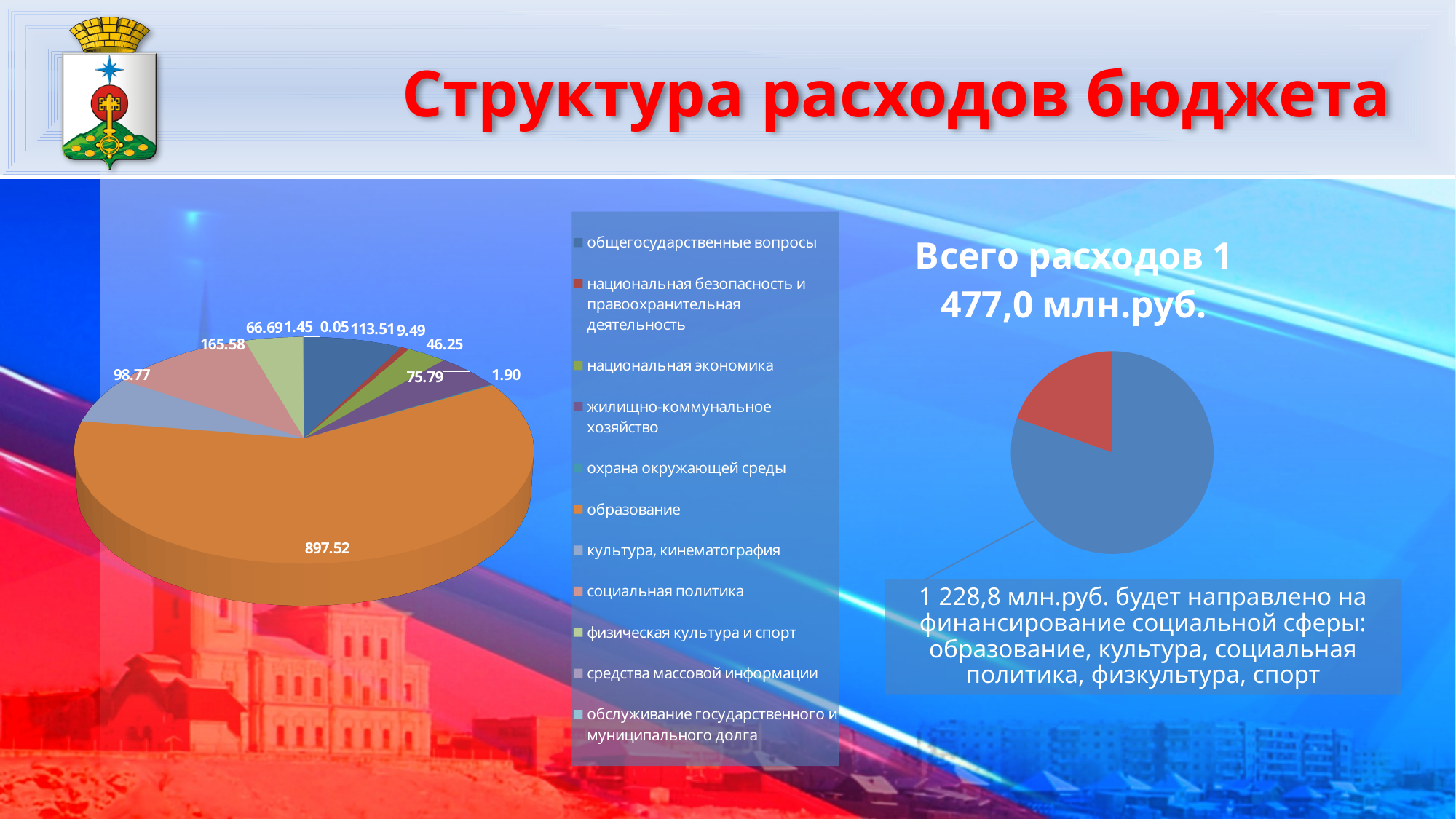
On the left pie chart, what value is shown for общегосударственные вопросы? 113.51 What colour is the образование slice on the left pie chart? orange How many categories does the legend of the left pie chart list? 11 How many slices does the small pie chart on the right of the slide have? 2 On the left pie chart, what value is shown for образование? 897.52 On the left pie chart, which category has the largest value? образование On the left pie chart, what is the difference between социальная политика and культура, кинематография? 66.81 On the left pie chart, which category has the smallest value? обслуживание государственного и муниципального долга On the left pie chart, what value is shown for жилищно-коммунальное хозяйство? 75.79 On the left pie chart, which is larger: жилищно-коммунальное хозяйство or физическая культура и спорт? жилищно-коммунальное хозяйство On the left pie chart, what value is shown for социальная политика? 165.58 What type of chart is shown on the left of the slide? pie chart